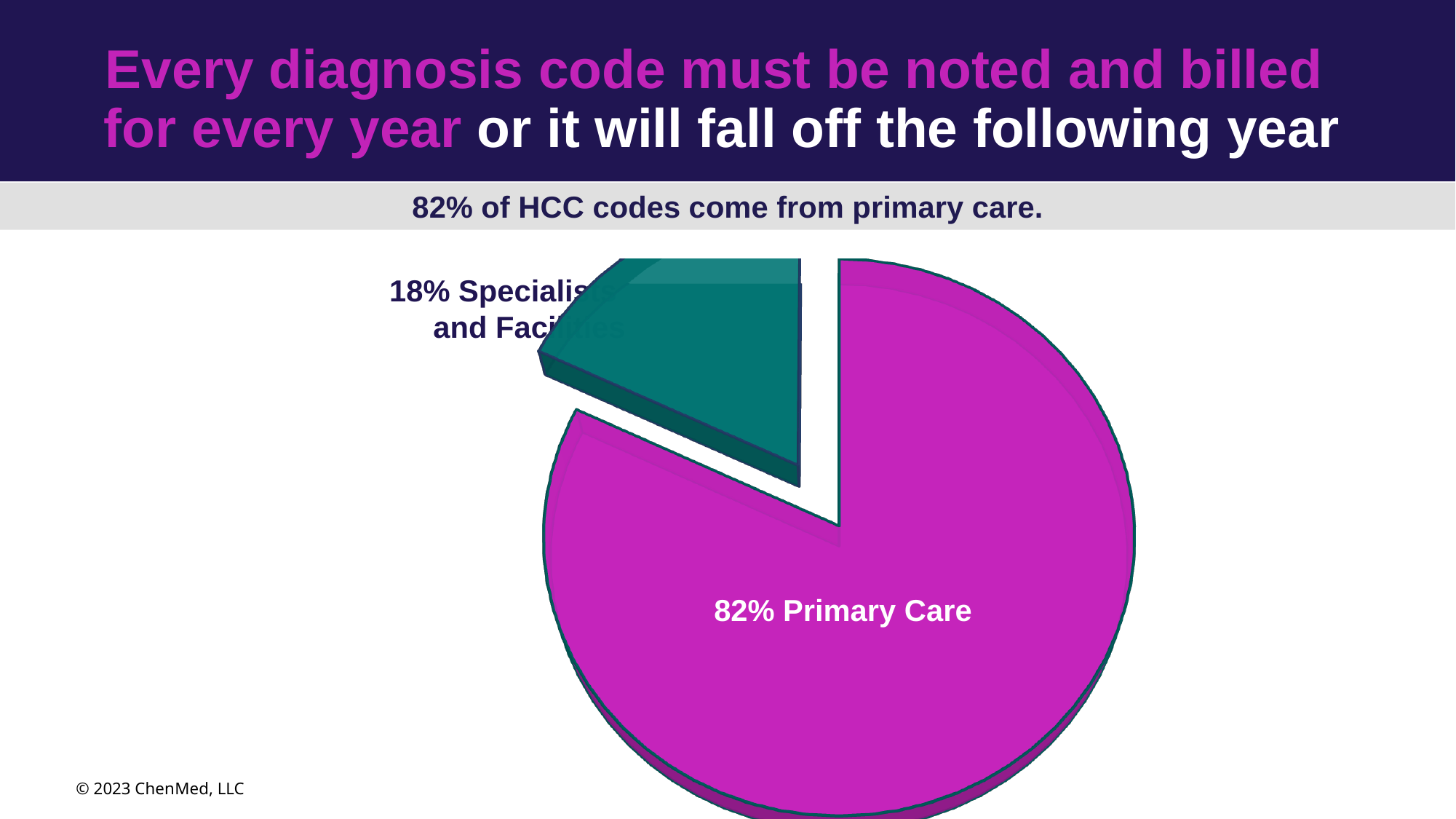
What share of HCC codes comes from Specialists and Facilities according to the pie chart? 18% How many slices does the pie chart have? 2 What colour is the Primary Care slice of the pie chart? Magenta What is the difference in percentage points between the Primary Care slice and the Specialists and Facilities slice? 64 What colour is the Specialists and Facilities slice of the pie chart? Teal Which slice of the pie chart is the largest? Primary Care What kind of chart is shown on the slide? Pie chart Which slice of the pie chart is the smallest? Specialists and Facilities What share of HCC codes comes from Primary Care according to the pie chart? 82% Which is larger, the Primary Care slice or the Specialists and Facilities slice? Primary Care